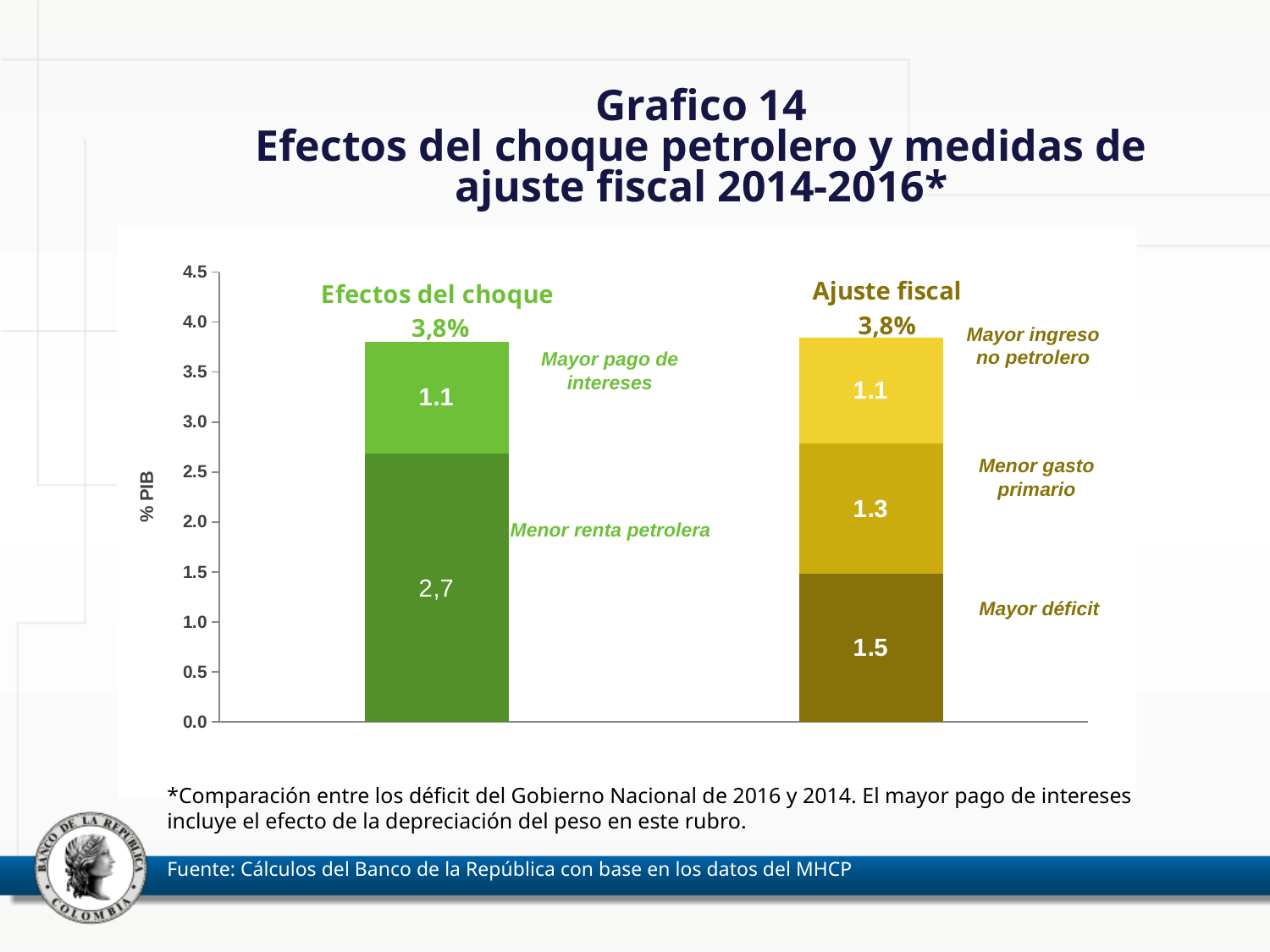
What is the total shown above the 'Ajuste fiscal' bar? 3,8% What is the value of the 'Menor gasto primario' segment in the 'Ajuste fiscal' bar? 1.3 What is the label of the vertical axis? % PIB What is the difference between the 'Menor renta petrolera' segment (2,7) and the 'Mayor pago de intereses' segment (1.1)? 1.6 What is the value of the 'Mayor ingreso no petrolero' segment in the 'Ajuste fiscal' bar? 1.1 What is the value of the 'Mayor pago de intereses' segment in the 'Efectos del choque' bar? 1.1 Which segment of the 'Ajuste fiscal' bar is the smallest? Mayor ingreso no petrolero What is the total shown above the 'Efectos del choque' bar? 3,8% What is the value of the 'Menor renta petrolera' segment in the 'Efectos del choque' bar? 2,7 What type of chart is shown on the slide? stacked bar chart Which segment of the 'Ajuste fiscal' bar is the largest? Mayor déficit What is the value of the 'Mayor déficit' segment in the 'Ajuste fiscal' bar? 1.5